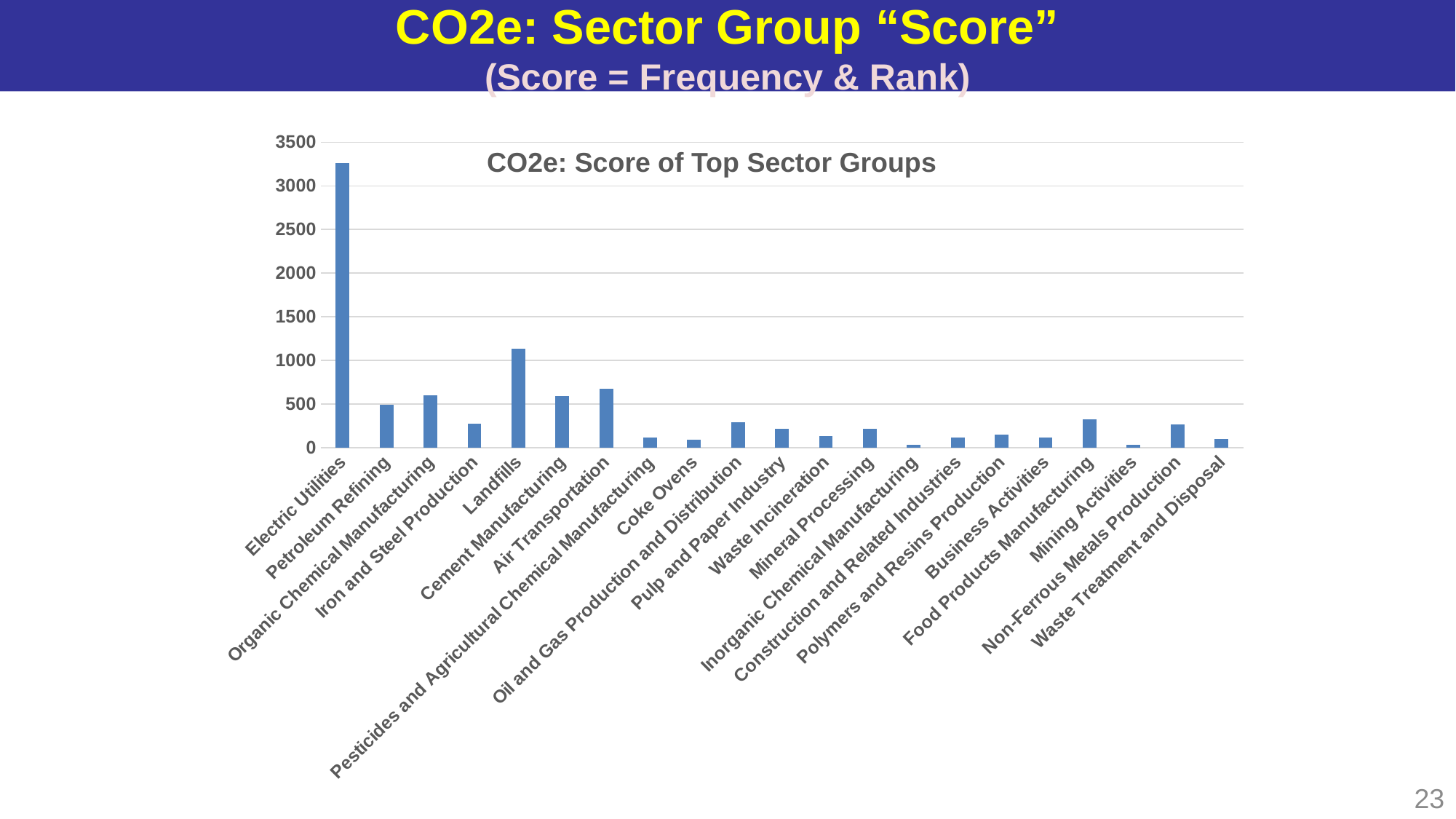
Is the score for Electric Utilities greater or less than 3000? greater Is the score for Food Products Manufacturing greater or less than 500? less What kind of chart is shown on the slide? Bar chart Which has a higher score, Landfills or Air Transportation? Landfills What is the title of the chart? CO2e: Score of Top Sector Groups Which has a higher score, Oil and Gas Production and Distribution or Coke Ovens? Oil and Gas Production and Distribution Which has a higher score, Electric Utilities or Cement Manufacturing? Electric Utilities Is the score for Iron and Steel Production greater or less than 500? less How many sector groups are plotted on the chart? 21 Which sector group has the highest score? Electric Utilities